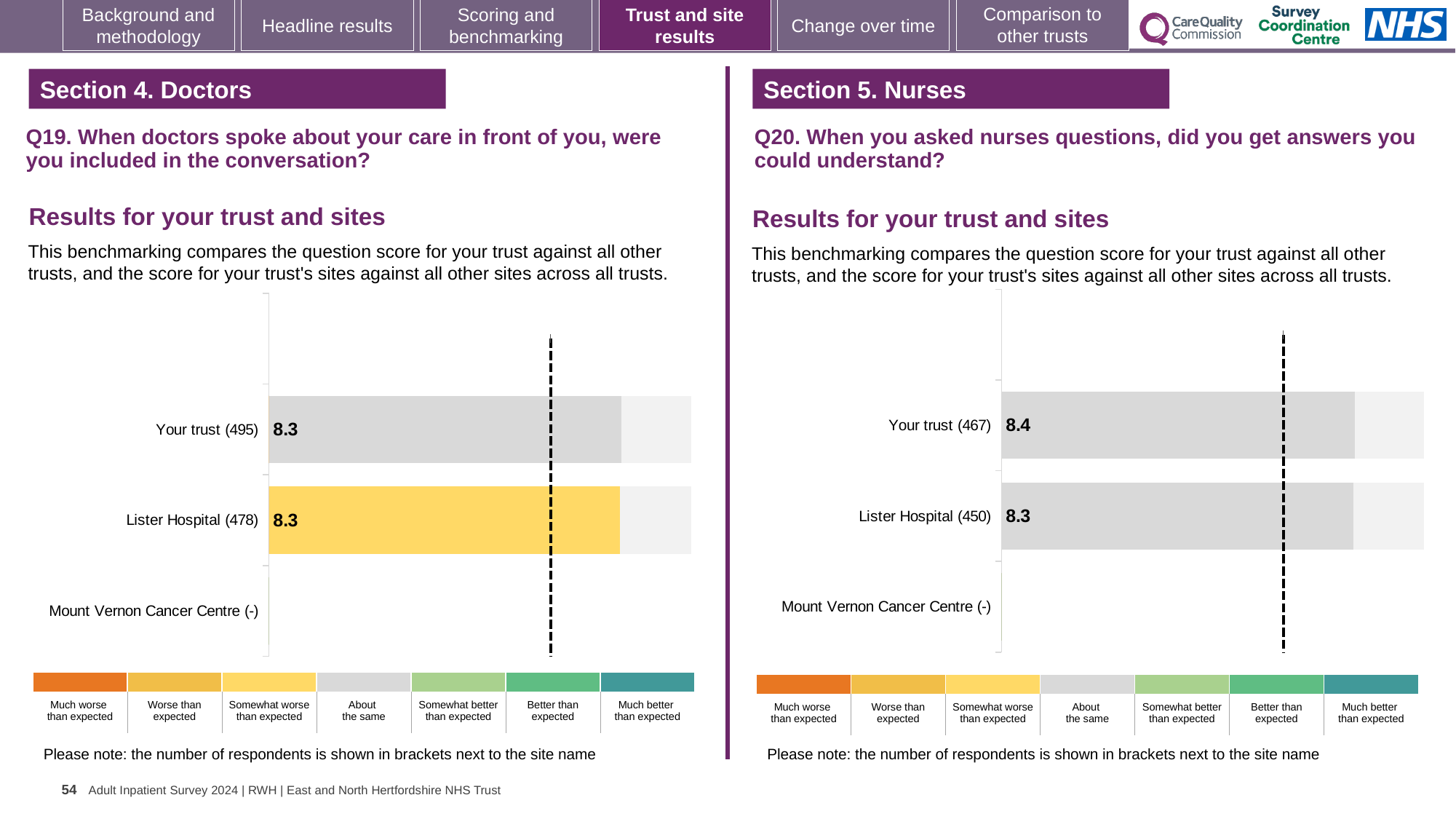
How many site/trust rows are listed in the Q19 chart on the left? 3 In the Q19 chart on the left, what is the score for Your trust? 8.3 In the Q20 chart on the right, what is the score for Lister Hospital? 8.3 How many benchmark categories does the colour key below the Q20 chart on the right list? 7 In the Q20 chart on the right, what is the difference between the scores for Your trust and Lister Hospital? 0.1 In the Q20 chart on the right, what is the score for Your trust? 8.4 In the Q19 chart on the left, which benchmark category does the yellow colour of the Lister Hospital bar indicate? Somewhat worse than expected In the Q20 chart on the right, how many respondents are shown in brackets for Your trust? 467 What kind of chart is used in the Q20 chart on the right? Bar chart In the Q19 chart on the left, what is the score for Lister Hospital? 8.3 In the Q19 chart on the left, how many respondents are shown in brackets for Lister Hospital? 478 In the Q20 chart on the right, which has the higher score, Your trust or Lister Hospital? Your trust